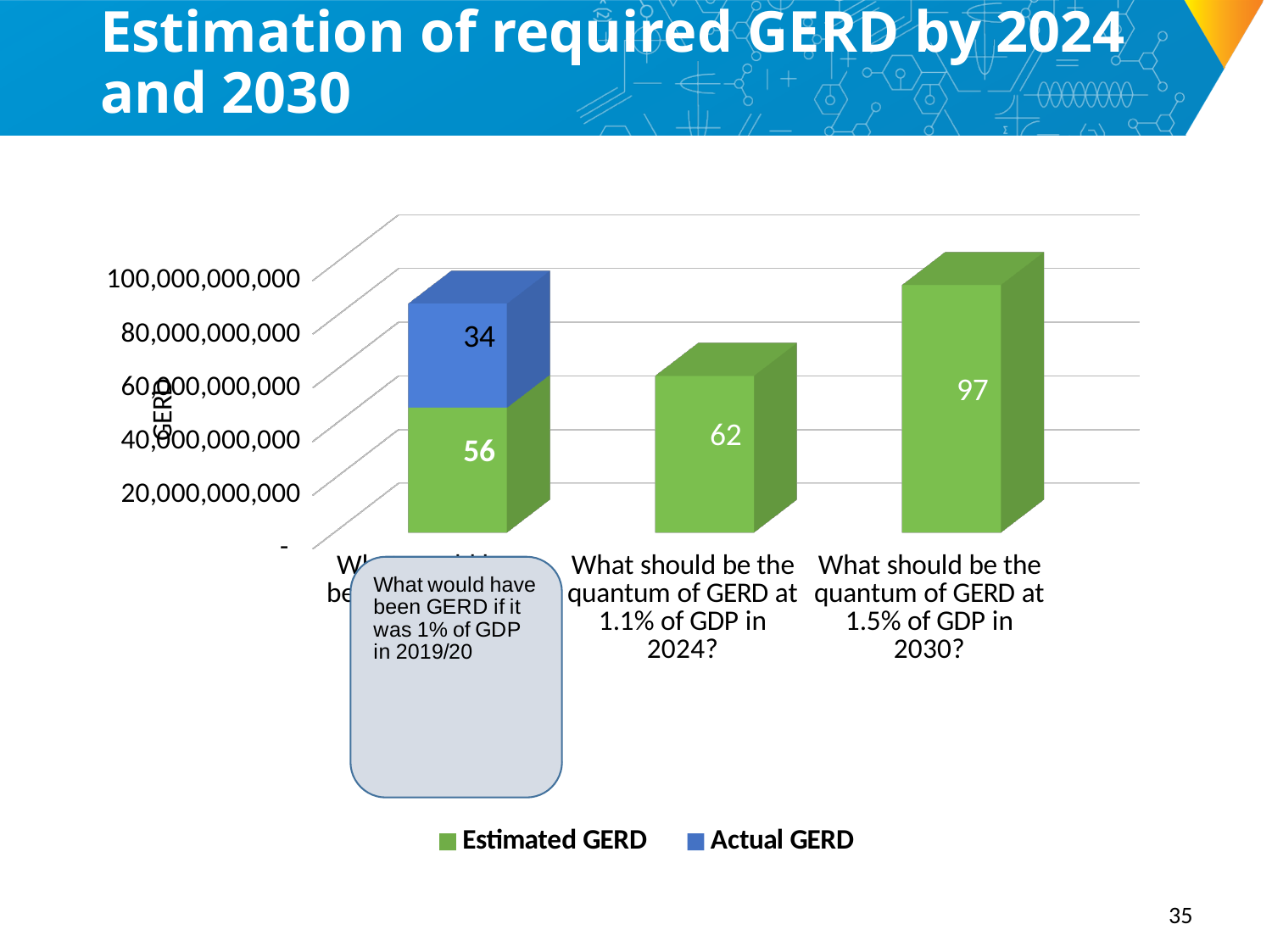
Which category has the lowest Estimated GERD value? What would have been GERD if it was 1% of GDP in 2019/20 How many series does the legend list? 2 What is the Estimated GERD value shown for the 1% of GDP in 2019/20 category? 56 Which category has the highest Estimated GERD value? What should be the quantum of GERD at 1.5% of GDP in 2030? What kind of chart is shown on the slide? Bar chart How many categories are shown on the x axis of the chart? 3 What is the Actual GERD value shown for the 1% of GDP in 2019/20 category? 34 In the 2019/20 category, how much larger is Estimated GERD (56) than Actual GERD (34)? 22 What is the total of the stacked bar for the 1% of GDP in 2019/20 category (Estimated GERD plus Actual GERD)? 90 What is the difference between the Estimated GERD values for 2030 (97) and 2024 (62)? 35 What is the Estimated GERD value for the category 'What should be the quantum of GERD at 1.5% of GDP in 2030?'? 97 What is the Estimated GERD value for the category 'What should be the quantum of GERD at 1.1% of GDP in 2024?'? 62